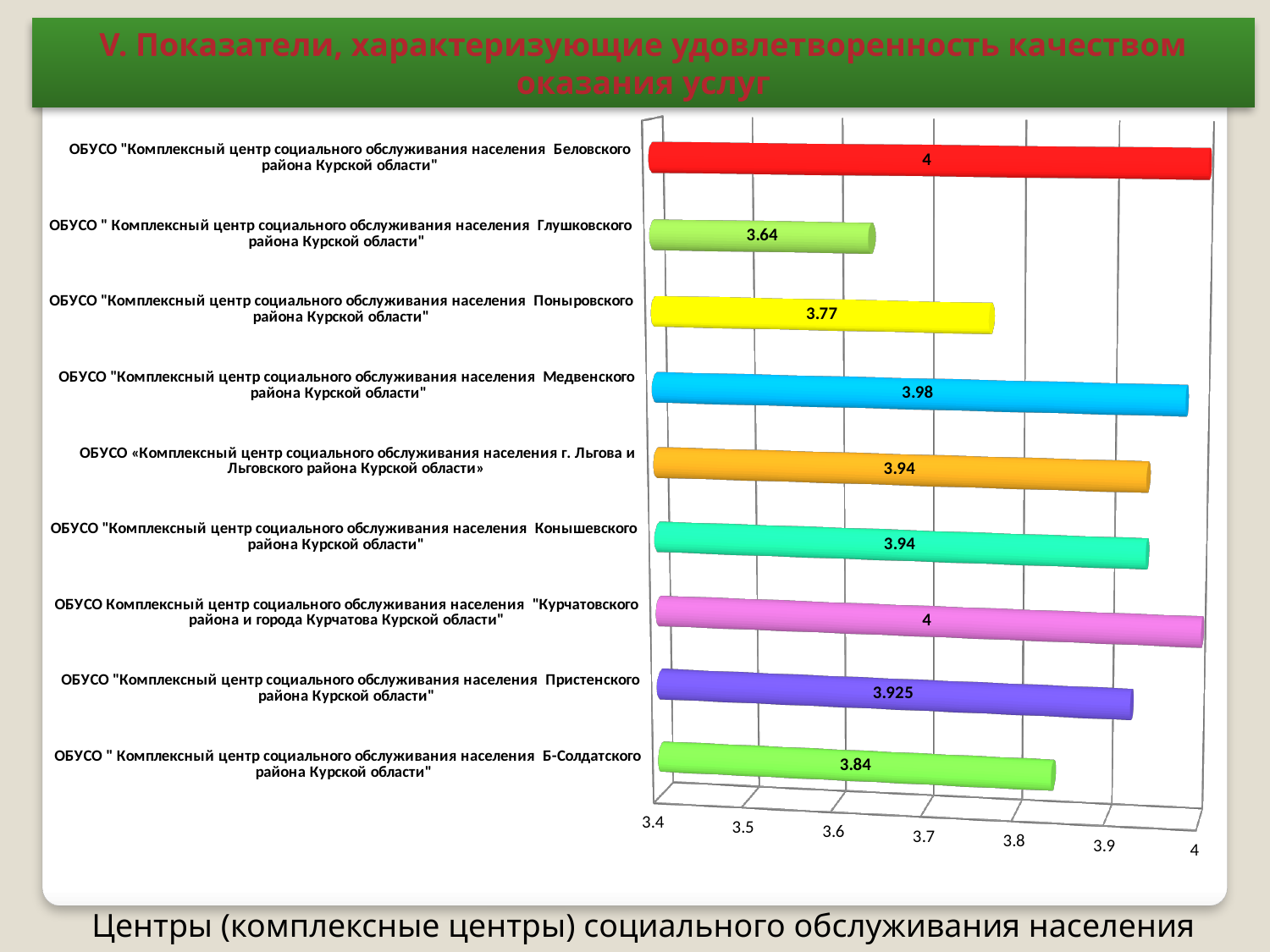
What is the value for ОБУСО "Комплексный центр социального обслуживания населения Пристенского района Курской области"? 3.925 Which has the larger value: the Пристенского centre or the Б-Солдатского centre? Пристенского centre Which centre has the lowest value on the chart? ОБУСО "Комплексный центр социального обслуживания населения Глушковского района Курской области" What is the difference between the values for the Медвенского centre and the Поныровского centre? 0.21 What is the value for ОБУСО "Комплексный центр социального обслуживания населения Глушковского района Курской области"? 3.64 What is the value for ОБУСО "Комплексный центр социального обслуживания населения Медвенского района Курской области"? 3.98 What is the difference between the values for the Беловского centre and the Глушковского centre? 0.36 What is the value for ОБУСО "Комплексный центр социального обслуживания населения Поныровского района Курской области"? 3.77 How many centres are shown on the chart? 9 What is the value for ОБУСО "Комплексный центр социального обслуживания населения Б-Солдатского района Курской области"? 3.84 Is the value for the Поныровского centre greater or less than 3.8? less What kind of chart is shown on the slide? bar chart